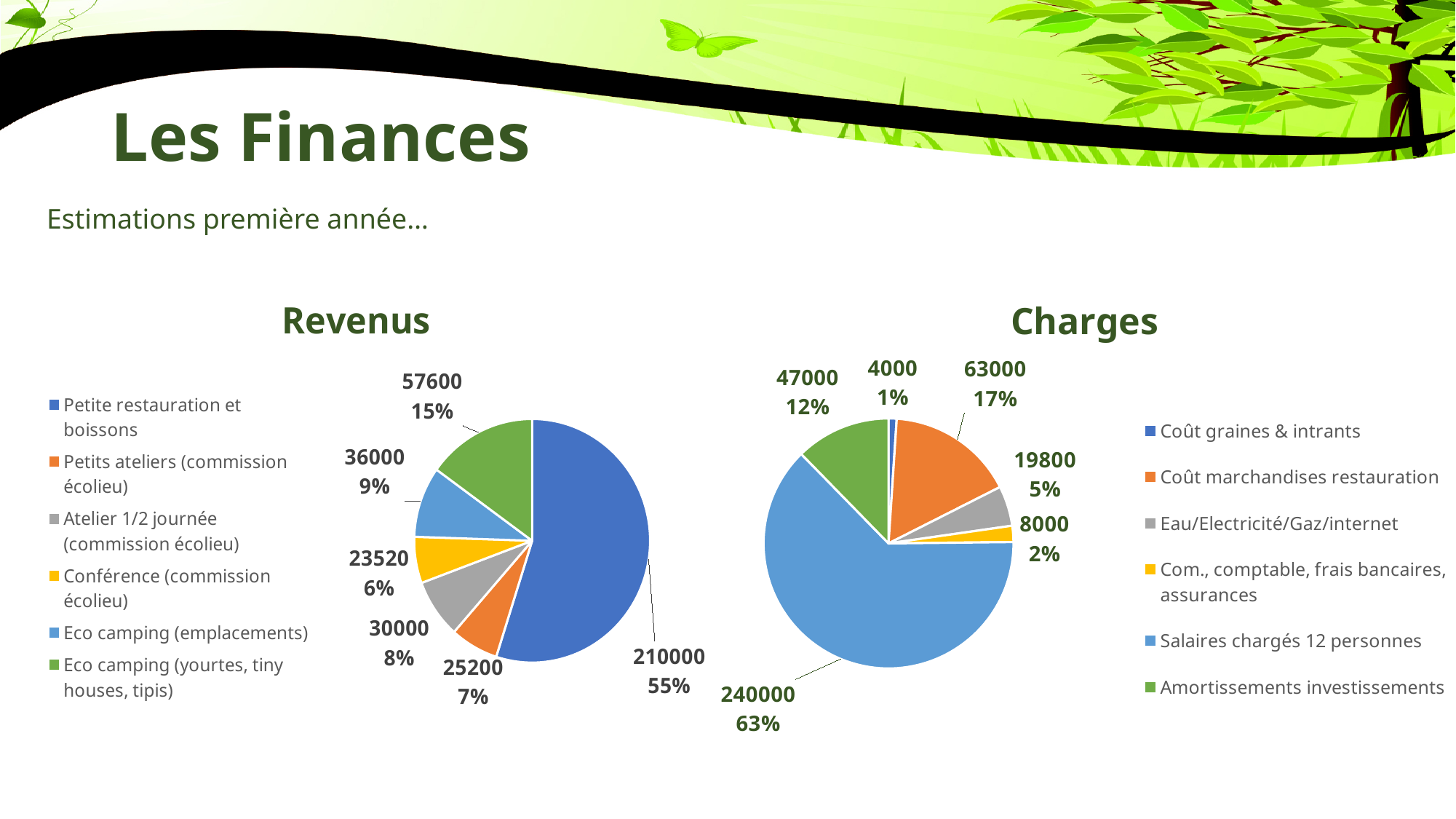
In the Revenus chart, what colour is the slice for Conférence (commission écolieu)? Yellow In the Charges chart, which is larger: Amortissements investissements or Eau/Electricité/Gaz/internet? Amortissements investissements In the Revenus chart, what is the difference between Eco camping (emplacements) and Petits ateliers (commission écolieu)? 10800 In the Charges chart, what share of the pie is Coût marchandises restauration? 17% In the Charges chart, what is the difference between Coût marchandises restauration and Amortissements investissements? 16000 In the Revenus chart, what share of the pie is Eco camping (yourtes, tiny houses, tipis)? 15% In the Revenus chart, which category has the smallest value? Conférence (commission écolieu) In the Revenus chart, what is the value for Petite restauration et boissons? 210000 In the Charges chart, what is the value for Salaires chargés 12 personnes? 240000 In the Charges chart, which category has the smallest value? Coût graines & intrants What type of chart is the Charges chart? Pie chart In the Revenus chart, how many categories are shown? 6